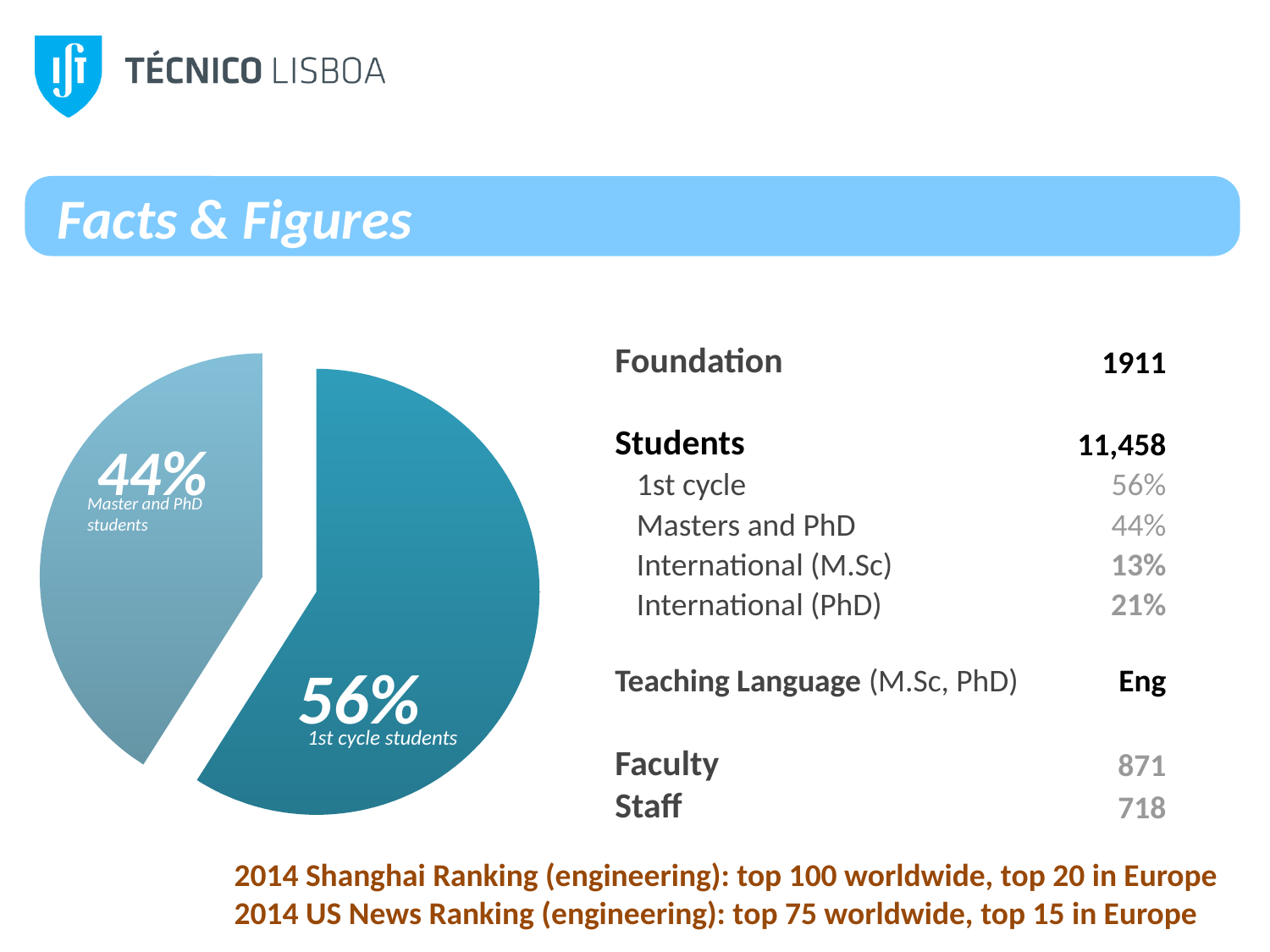
Which slice of the pie chart is pulled out (exploded) from the rest? 1st cycle students Is the share for Master and PhD students greater or less than 50%? less How many slices does the pie chart have? 2 Is the share for 1st cycle students greater or less than 50%? greater Which slice of the pie chart is the largest? 1st cycle students Which is larger in the pie chart: the 1st cycle students slice or the Master and PhD students slice? 1st cycle students Which slice of the pie chart is the smallest? Master and PhD students Which slice of the pie chart is drawn in the darker blue? 1st cycle students What share of the pie is labelled Master and PhD students? 44% What is the difference in percentage points between the 1st cycle students slice and the Master and PhD students slice? 12% What kind of chart is shown on the slide? pie chart What share of the pie is labelled 1st cycle students? 56%